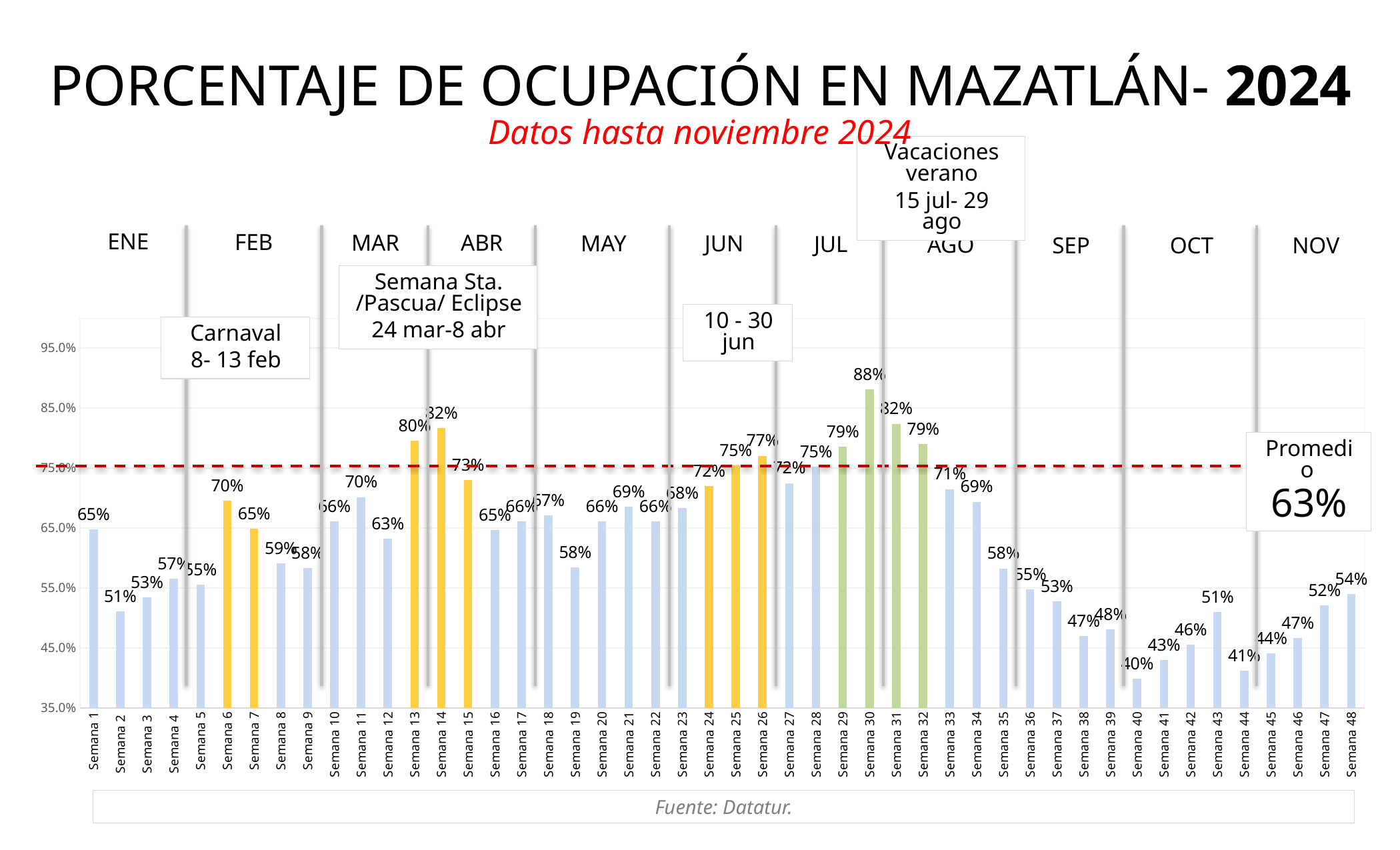
What is the difference in occupancy between Semana 30 and Semana 40? 48% What is the occupancy percentage for Semana 40? 40% What is the occupancy percentage for Semana 30? 88% What is the occupancy percentage for Semana 14? 82% Is the value for Semana 26 greater or less than 75.0%? greater Which has a higher occupancy percentage, Semana 6 or Semana 7? Semana 6 Which week has the lowest occupancy percentage? Semana 40 What kind of chart is shown on the slide? Bar chart How many weeks (bars) are plotted on the chart? 48 What is the difference in occupancy between Semana 13 and Semana 12? 17% What average (Promedio) value is indicated by the dashed red line? 63% Which week has the highest occupancy percentage? Semana 30